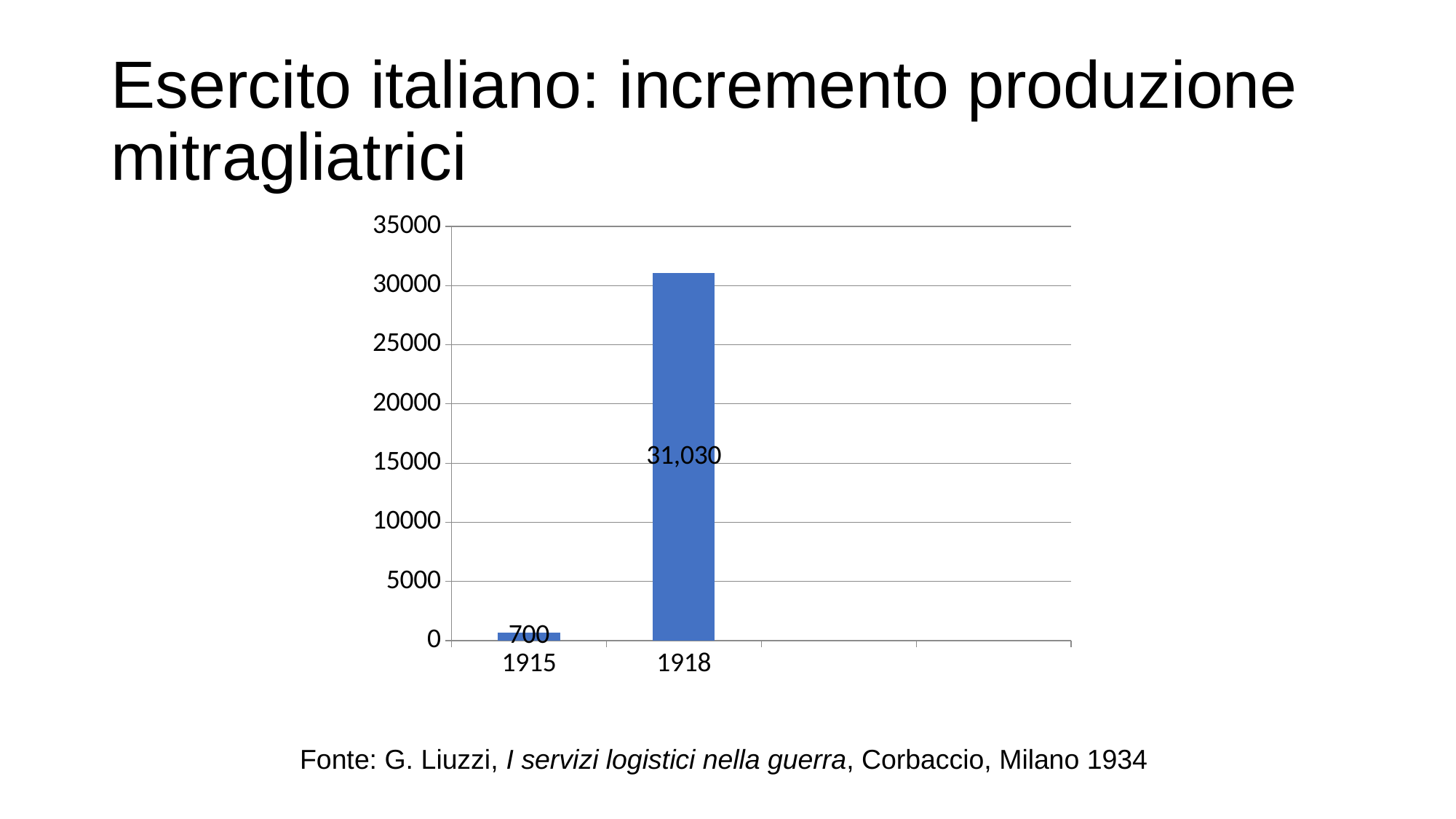
Is the value for 1918 greater or less than 30000? greater How many years are shown on the chart? 2 What is the difference between the values for 1918 and 1915? 30,330 Do the values rise or fall from 1915 to 1918? rise Which year has the lowest value? 1915 Which year has the highest value? 1918 Which is larger, the value for 1915 or the value for 1918? 1918 What is the highest value shown on the vertical axis? 35000 What is the value for 1915? 700 What kind of chart is shown on the slide? bar chart Is the value for 1915 greater or less than 5000? less What is the value for 1918? 31,030